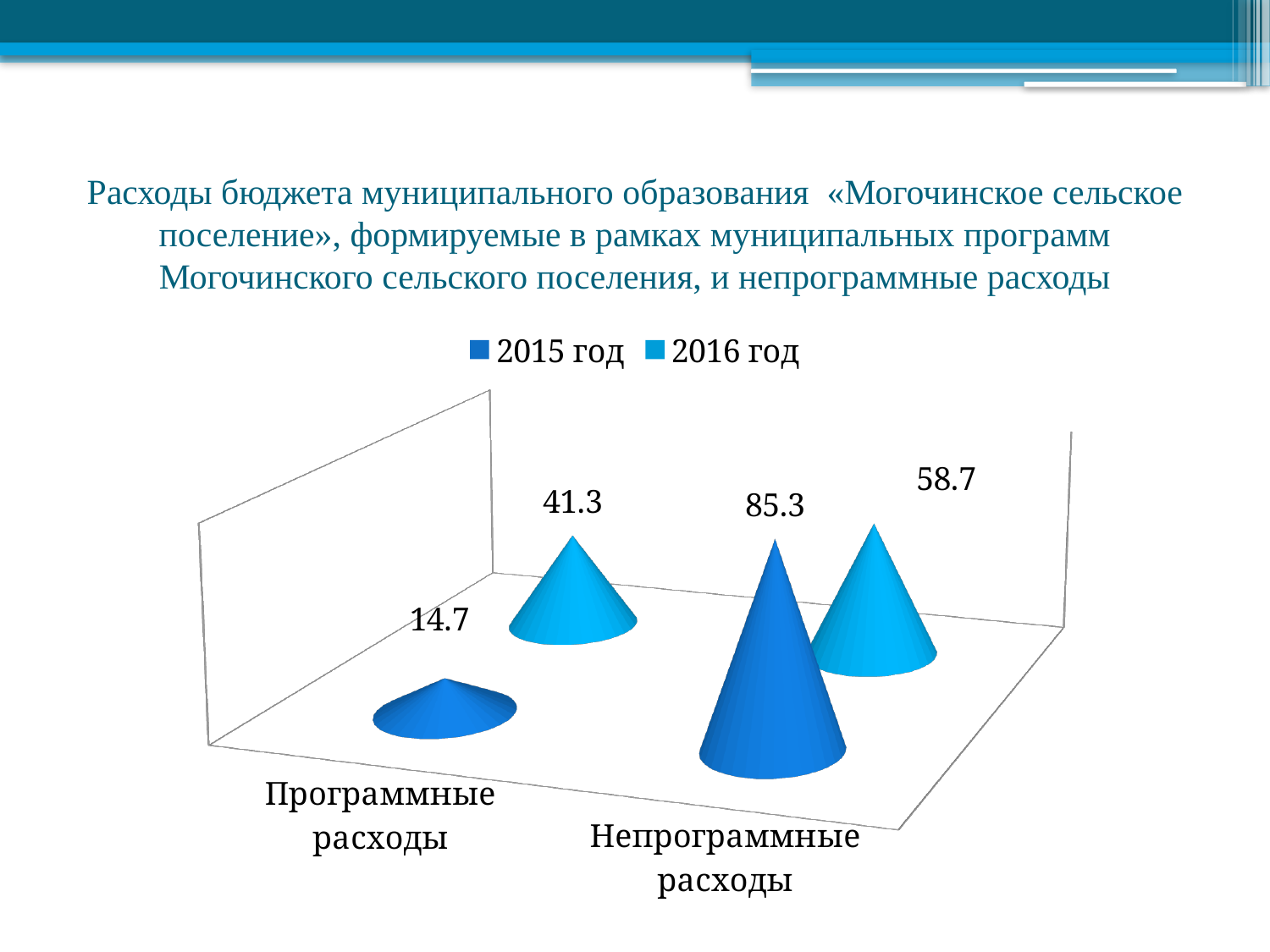
What kind of chart is shown on the slide? 3D bar chart (cone-shaped bars) How many series does the chart legend list? 2 Which category has the lowest value in the 2016 год series? Программные расходы What is the value for Программные расходы in the 2016 год series? 41.3 How many categories are shown on the x axis of the chart? 2 What is the difference between the 2016 год and 2015 год values for Программные расходы? 26.6 What is the value for Непрограммные расходы in the 2015 год series? 85.3 What is the value for Непрограммные расходы in the 2016 год series? 58.7 Which category has the highest value in the 2015 год series? Непрограммные расходы What is the difference between the 2015 год and 2016 год values for Непрограммные расходы? 26.6 What is the value for Программные расходы in the 2015 год series? 14.7 Which is larger for Программные расходы: the 2015 год value or the 2016 год value? 2016 год